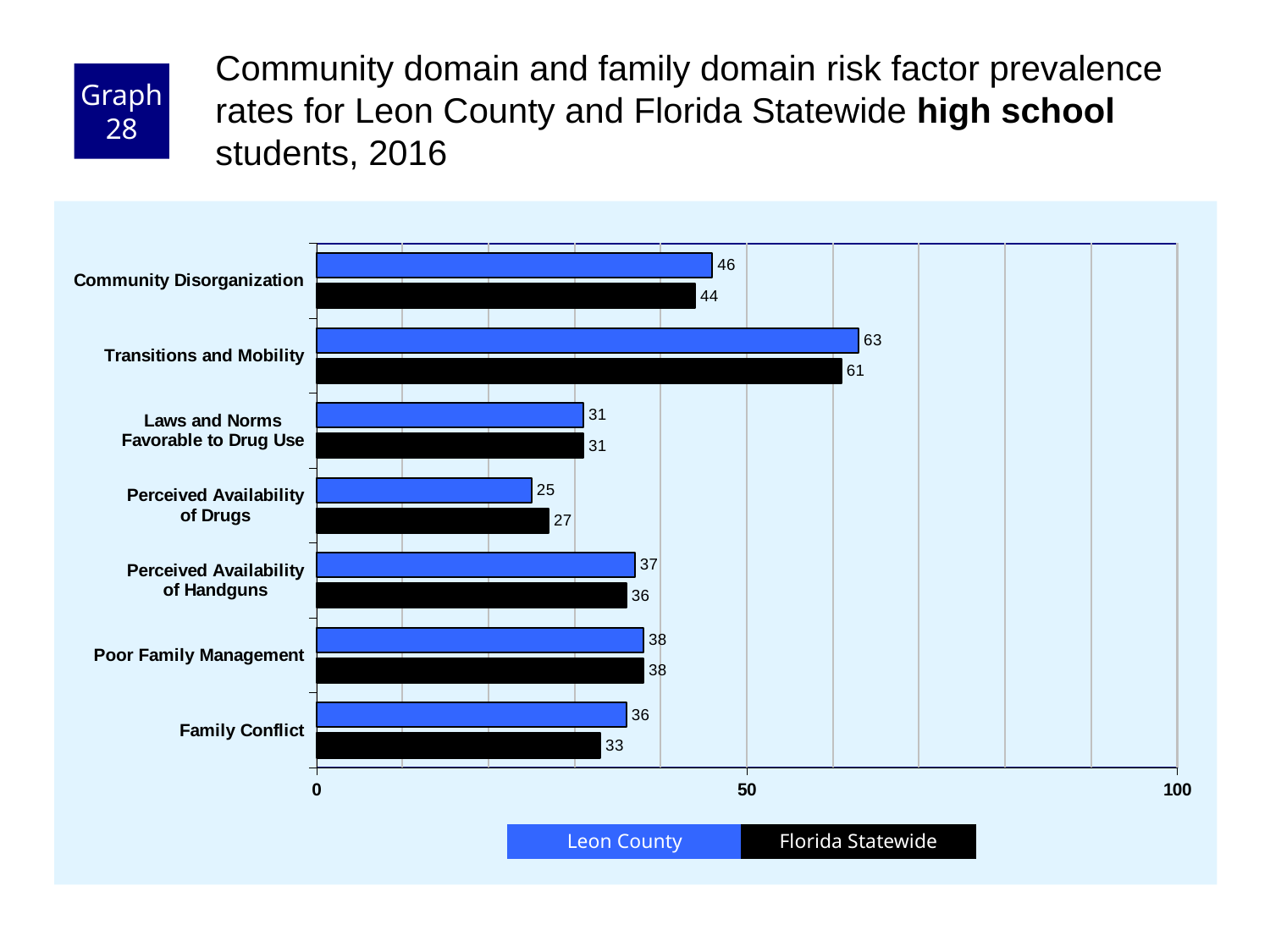
Which colour represents Florida Statewide in the chart? Black What kind of chart is shown on the slide? Bar chart How many series does the legend list? 2 Which is larger for Perceived Availability of Drugs: the Leon County value or the Florida Statewide value? Florida Statewide What is the Florida Statewide value for Community Disorganization? 44 What is the Leon County value for Transitions and Mobility? 63 How many risk factors are shown on the chart? 7 Which risk factor has the highest Leon County value? Transitions and Mobility What is the Florida Statewide value for Family Conflict? 33 Is the Leon County value for Transitions and Mobility greater or less than 50? greater Which risk factor has the lowest Florida Statewide value? Perceived Availability of Drugs What is the difference between the Leon County and Florida Statewide values for Transitions and Mobility? 2